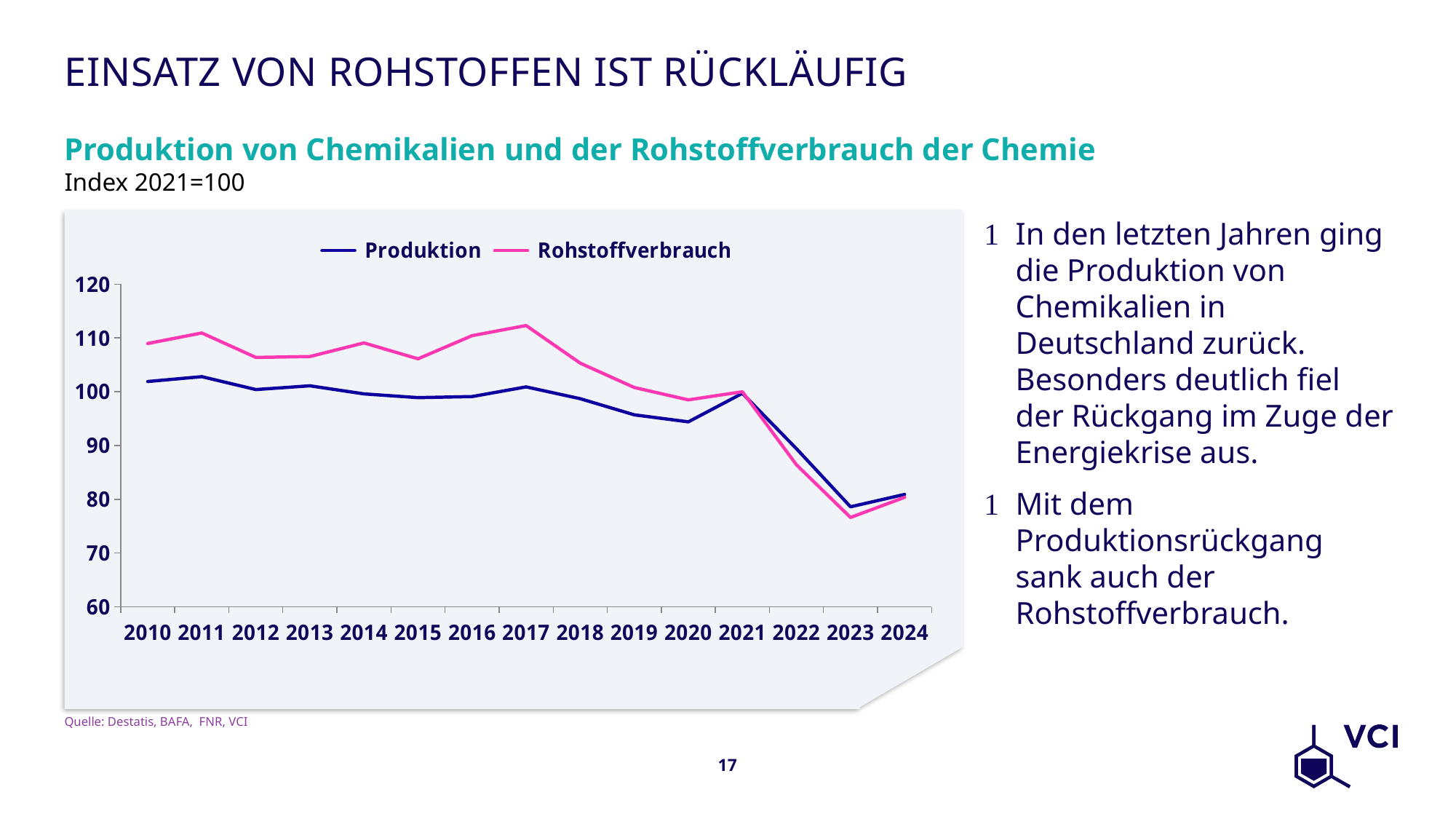
In 2017, which series has the higher value, Produktion or Rohstoffverbrauch? Rohstoffverbrauch In which year is the Rohstoffverbrauch line at its lowest? 2023 Does the Produktion line rise or fall from 2021 to 2023? fall How many years are shown on the x axis of the chart? 15 Is the value for Produktion in 2020 greater or less than 100? less Is the value for Rohstoffverbrauch in 2023 greater or less than 80? less What kind of chart is shown on the slide? line chart What colour is the Rohstoffverbrauch line in the chart? pink Is the value for Rohstoffverbrauch in 2010 greater or less than 100? greater How many series does the chart's legend list? 2